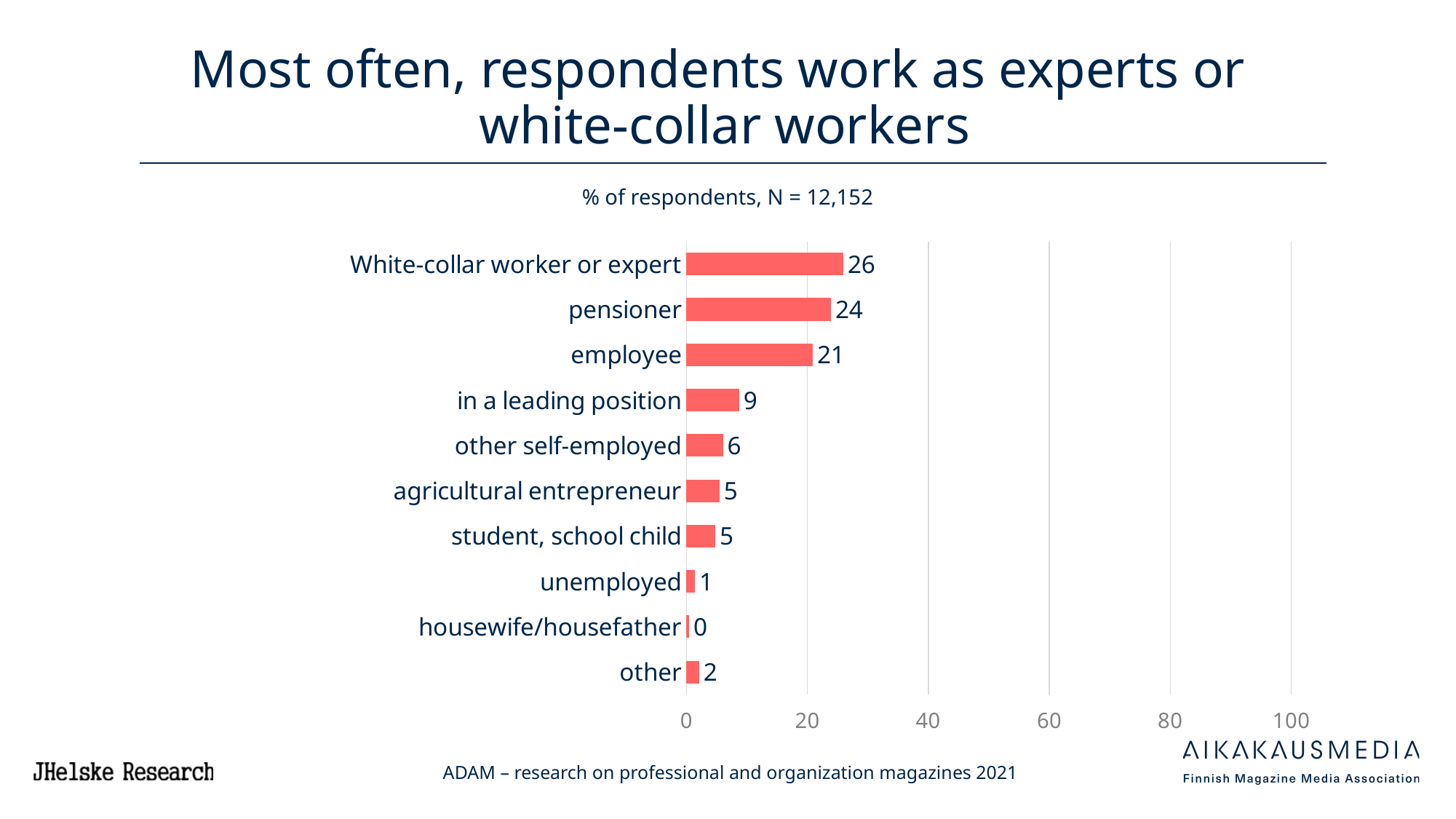
What is the value for 'housewife/housefather'? 0 How many categories are shown in the chart? 10 What is the value for 'in a leading position'? 9 What is the value for 'White-collar worker or expert'? 26 Is the value for 'employee' greater or less than 20? greater What is the value for 'pensioner'? 24 Which is larger, the value for 'pensioner' or the value for 'employee'? pensioner What is the difference between the values for 'White-collar worker or expert' and 'employee'? 5 Which category has the highest value? White-collar worker or expert What kind of chart is shown on the slide? bar chart Which category has the lowest value? housewife/housefather What is the subtitle shown above the chart? % of respondents, N = 12,152